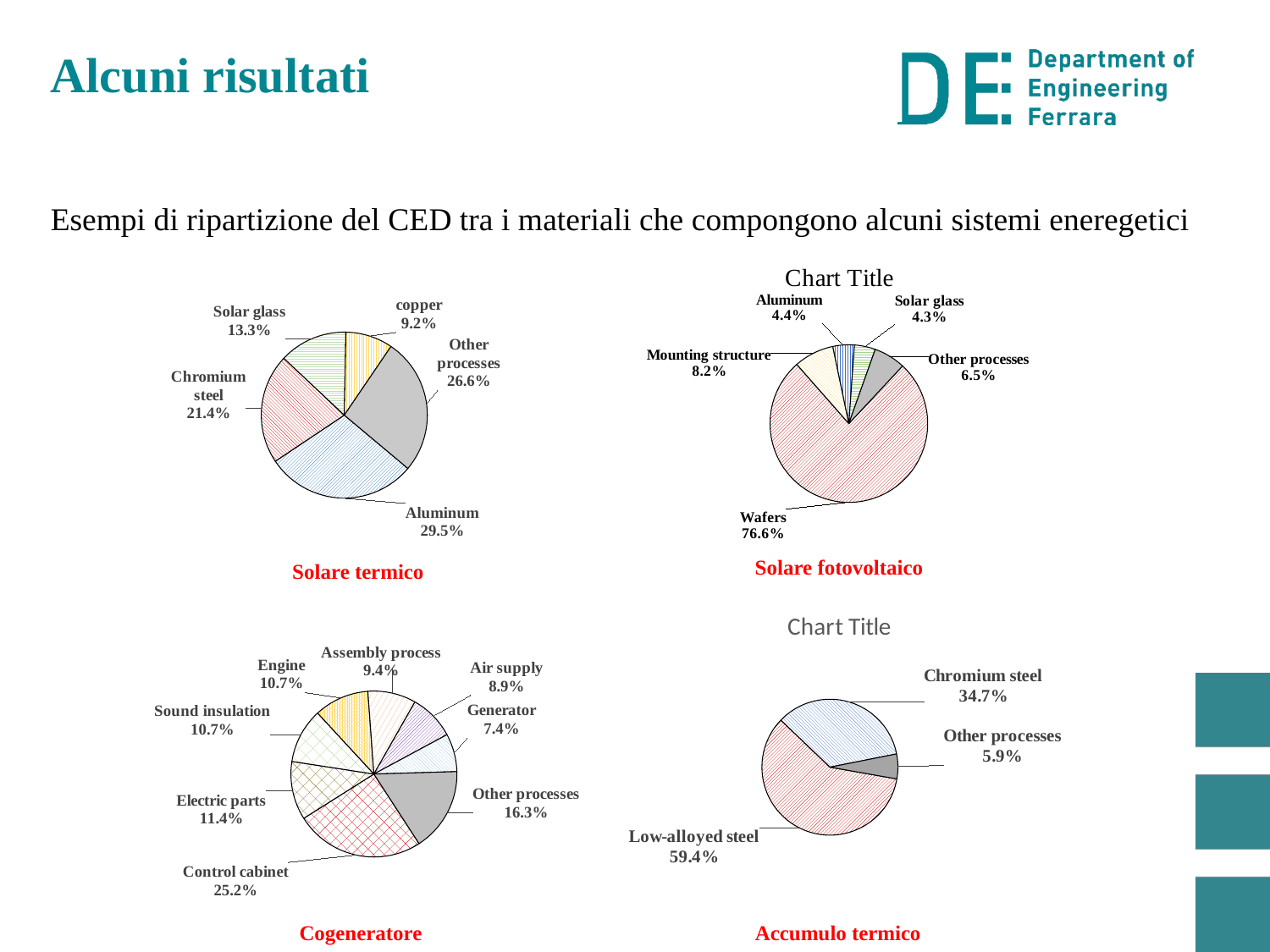
In the Accumulo termico pie chart, what share does Low-alloyed steel have? 59.4% What type of chart is the Accumulo termico chart? Pie chart In the Solare termico pie chart, which category has the smallest share? copper In the Accumulo termico pie chart, what is the difference between the Chromium steel share and the Other processes share? 28.8% In the Solare fotovoltaico pie chart, what share does Mounting structure have? 8.2% In the Solare fotovoltaico pie chart, which category has the largest share? Wafers In the Cogeneratore pie chart, which category has the smallest share? Generator In the Cogeneratore pie chart, what share does Control cabinet have? 25.2% In the Solare fotovoltaico pie chart, which is larger, Other processes or Aluminum? Other processes In the Solare termico pie chart, what is the difference between the Other processes share and the Chromium steel share? 5.2% How many categories are shown in the Cogeneratore pie chart? 8 In the Solare termico pie chart, what share does Aluminum have? 29.5%